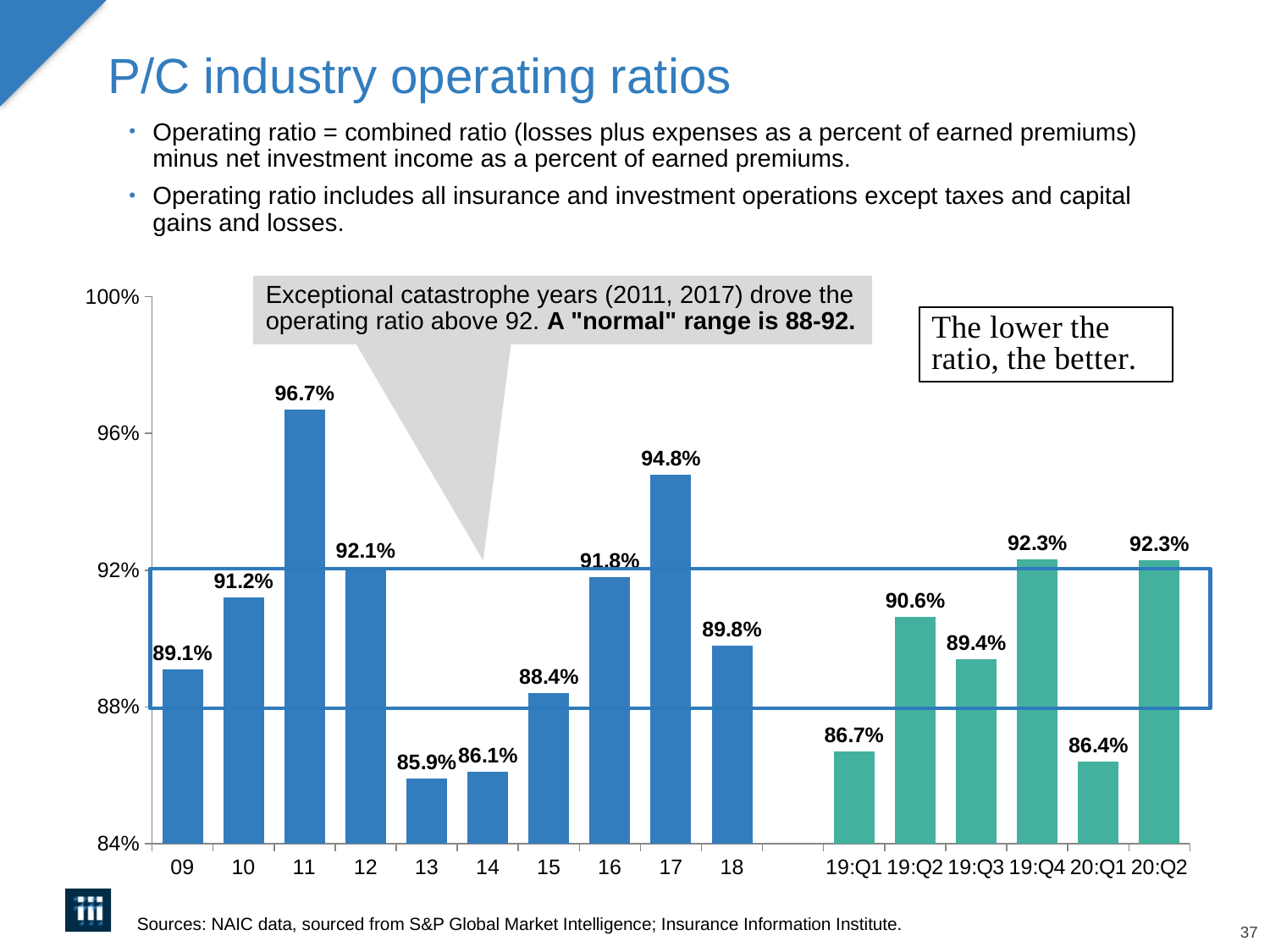
What kind of chart is shown on the slide? Bar chart What is the operating ratio for 2013 (labelled 13)? 85.9% How many bars are plotted in the chart? 16 Which category has the highest operating ratio? 11 Is the value for 20:Q1 greater or less than 88%? less According to the annotation on the chart, what is the "normal" range for the operating ratio? 88-92 What is the operating ratio for 2011 (labelled 11)? 96.7% What is the difference between the operating ratios for 11 and 17? 1.9 percentage points What is the operating ratio for 19:Q4? 92.3% Which category has the lowest operating ratio? 13 Do the operating ratios rise or fall from 09 to 11? Rise Which has a higher operating ratio, 10 or 16? 16